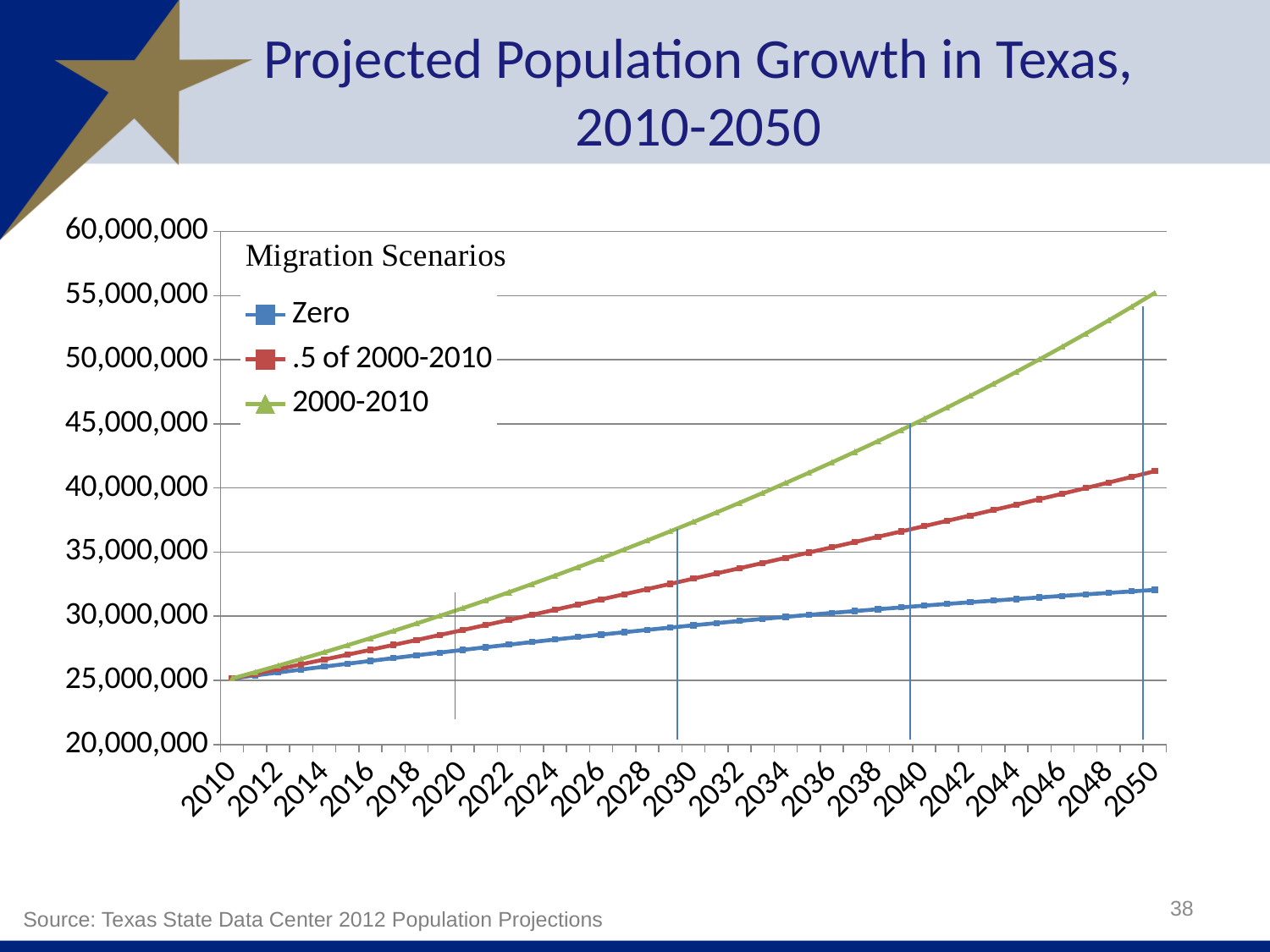
Which migration scenario has the lowest projected population in 2050? Zero Do the values for the 2000-2010 scenario rise or fall from 2010 to 2050? Rise What heading appears above the legend entries? Migration Scenarios Is the value for the Zero scenario in 2050 greater or less than 30,000,000? greater Is the value for the Zero scenario in 2030 greater or less than 30,000,000? less What is the title of the chart? Projected Population Growth in Texas, 2010-2050 What kind of chart is shown on the slide? Line chart Which migration scenario has the highest projected population in 2050? 2000-2010 Is the value for the .5 of 2000-2010 scenario in 2050 greater or less than 35,000,000? greater How many series does the legend list? 3 In 2040, which is larger: the value for the 2000-2010 scenario or the value for the Zero scenario? 2000-2010